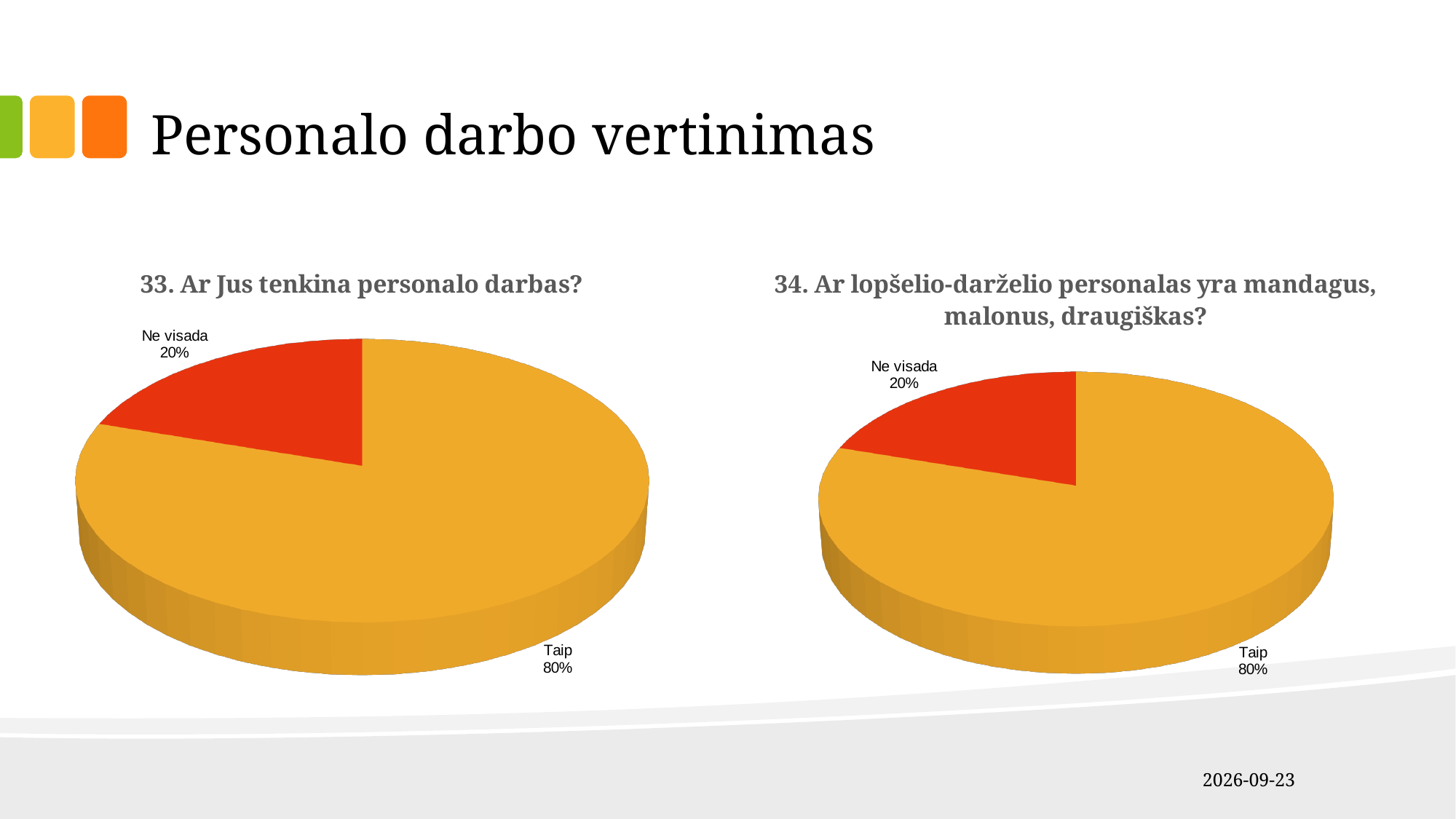
In the left chart titled "33. Ar Jus tenkina personalo darbas?", what is the difference in percentage points between "Taip" and "Ne visada"? 60 percentage points How many slices does the left chart titled "33. Ar Jus tenkina personalo darbas?" have? 2 In the left chart titled "33. Ar Jus tenkina personalo darbas?", what share of the pie is "Ne visada"? 20% In the right chart titled "34. Ar lopšelio-darželio personalas yra mandagus, malonus, draugiškas?", what share of the pie is "Taip"? 80% How many charts are shown on the slide? 2 What kind of chart is the right chart titled "34. Ar lopšelio-darželio personalas yra mandagus, malonus, draugiškas?"? Pie chart In the left chart titled "33. Ar Jus tenkina personalo darbas?", what share of the pie is "Taip"? 80% In the left chart titled "33. Ar Jus tenkina personalo darbas?", what colour is the "Ne visada" slice? Red In the right chart titled "34. Ar lopšelio-darželio personalas yra mandagus, malonus, draugiškas?", which slice is the smallest? Ne visada In the right chart titled "34. Ar lopšelio-darželio personalas yra mandagus, malonus, draugiškas?", which is larger, "Taip" or "Ne visada"? Taip In the left chart titled "33. Ar Jus tenkina personalo darbas?", which slice is the largest? Taip